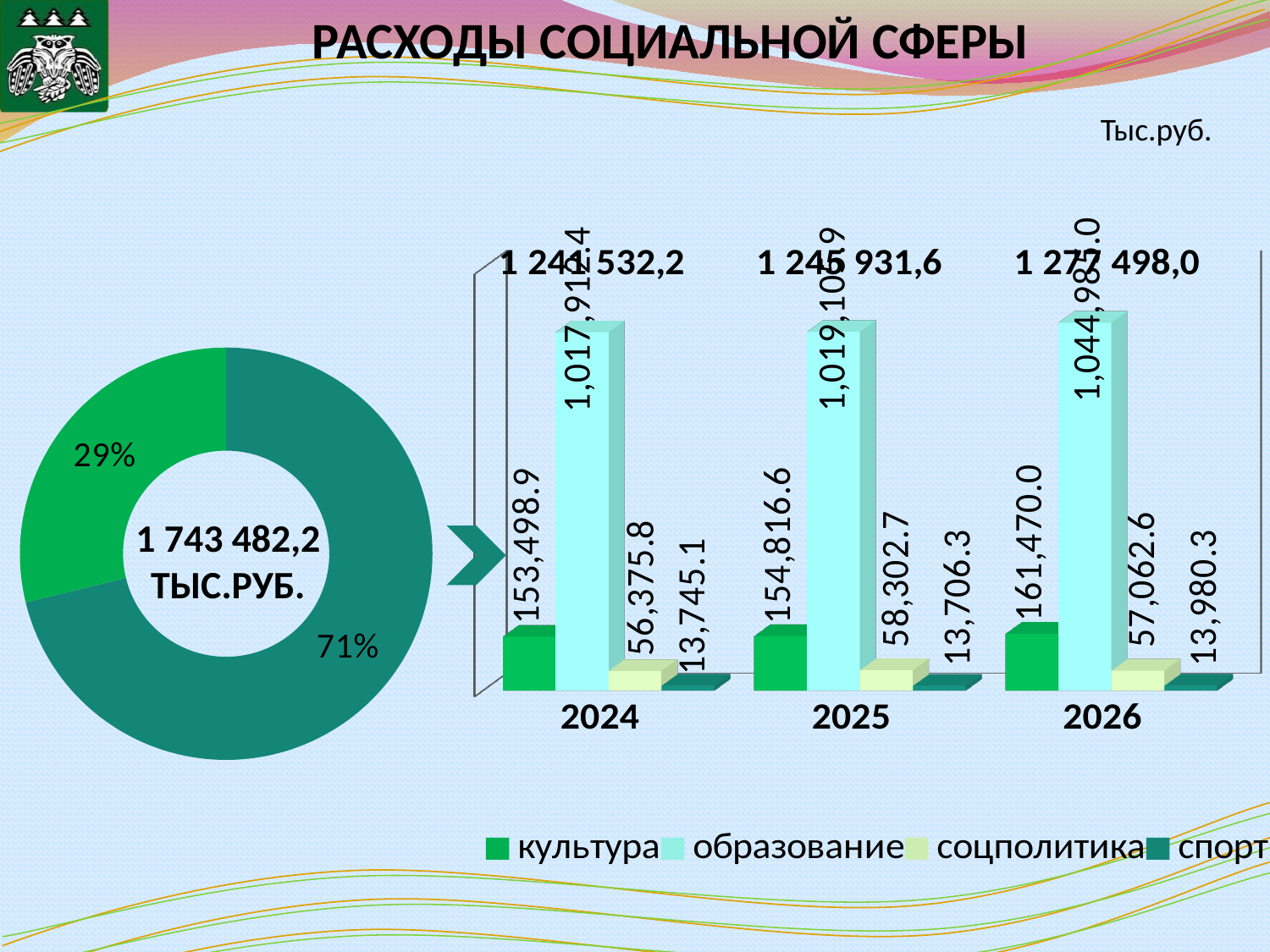
On the bar chart, what is the difference between the культура values for 2026 and 2024? 7,971.1 On the bar chart, what is the value for соцполитика in 2025? 58,302.7 On the donut chart, what share does the larger slice show? 71% On the bar chart, which series has the lowest value in 2025? спорт On the bar chart, what is the value for спорт in 2026? 13,980.3 How many series does the legend of the bar chart list? 4 On the bar chart, in which year is the value for культура the highest? 2026 On the bar chart, do the values for культура rise or fall from 2024 to 2026? rise On the bar chart, what is the value for культура in 2024? 153,498.9 On the bar chart, which year has the larger value for соцполитика, 2025 or 2026? 2025 How many years are shown on the x axis of the bar chart? 3 What kind of chart is shown on the right side of the slide? bar chart